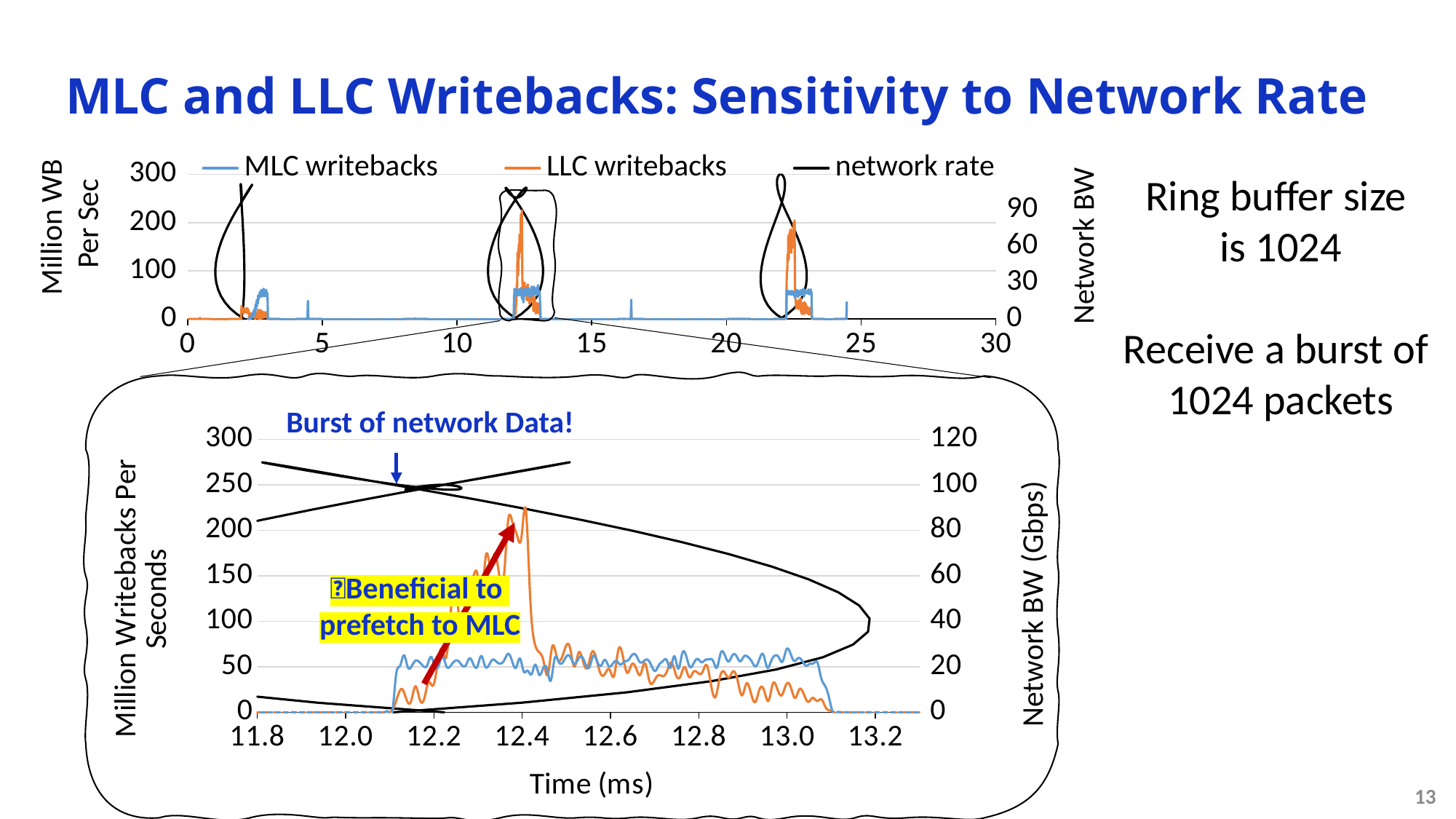
In the bottom (zoomed) chart, does the LLC writebacks series rise or fall between 12.2 ms and 12.4 ms? rise In the bottom (zoomed) chart, at 12.4 ms, which series is higher: LLC writebacks or MLC writebacks? LLC writebacks How many series does the legend of the top chart list? 3 What are the three series named in the legend of the top chart? MLC writebacks, LLC writebacks, network rate In the top chart, is the value of MLC writebacks around 22.5 ms greater or less than 100 on the left axis? less What type of chart is the top chart on the slide? Line chart In the bottom (zoomed) chart, does the LLC writebacks series rise or fall between 12.4 ms and 12.5 ms? fall In the bottom (zoomed) chart, is the value of MLC writebacks at 12.6 ms greater or less than 100? less In the bottom (zoomed) chart, what is the maximum value shown on the right-hand axis (Network BW)? 120 In the bottom (zoomed) chart, what is the x-axis title? Time (ms) In the bottom (zoomed) chart, is the peak value of LLC writebacks greater or less than 150? greater